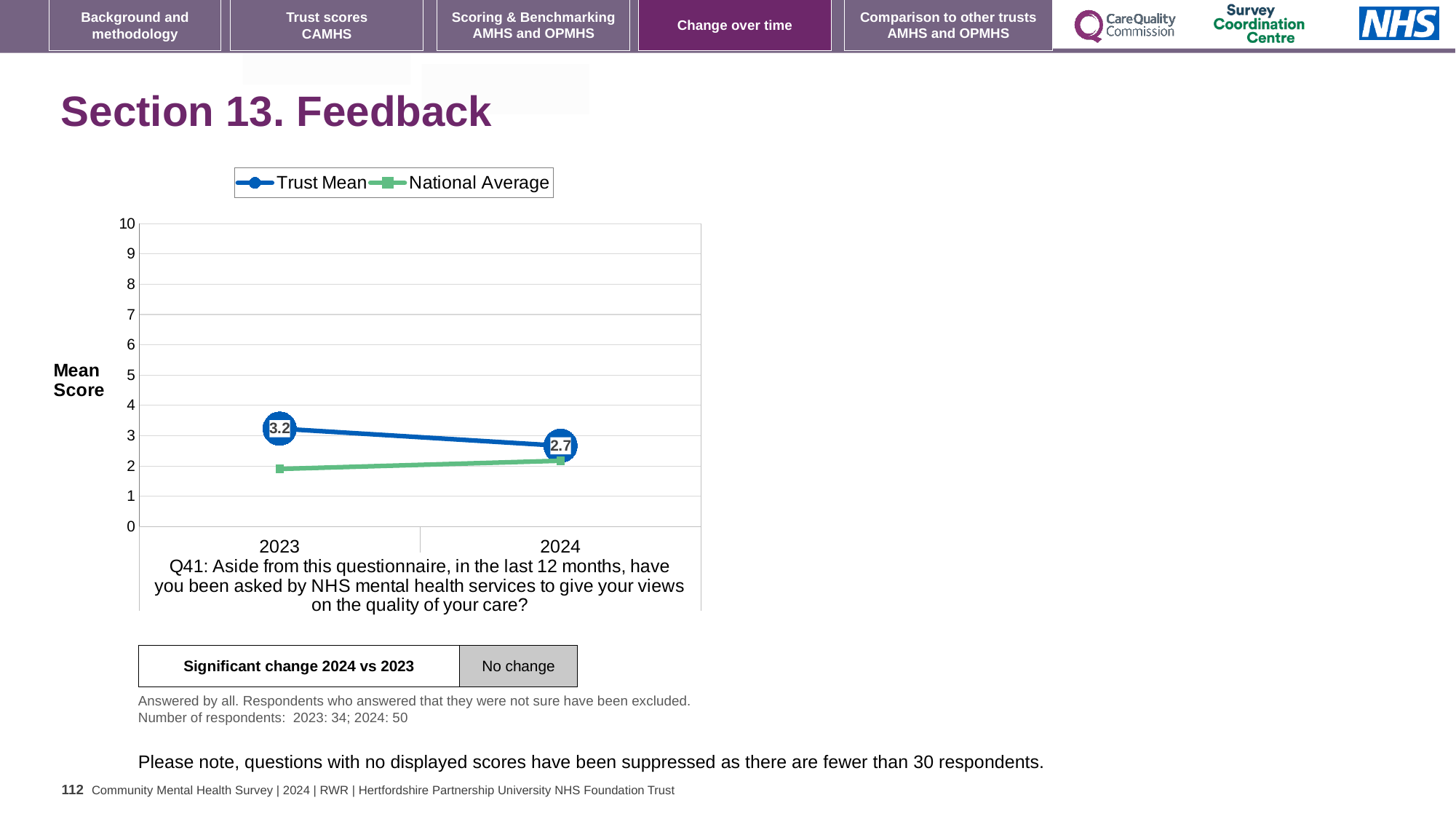
Does the Trust Mean line rise or fall from 2023 to 2024? fall How many years are shown on the x axis? 2 How many series does the legend list? 2 In which year was the Trust Mean score higher? 2023 Is the National Average value for 2023 greater or less than 3? less By how much did the Trust Mean score change from 2023 to 2024? 0.5 In which year was the Trust Mean score lower? 2024 What is the Trust Mean score for 2023? 3.2 In 2023, which is higher: the Trust Mean or the National Average? Trust Mean Does the National Average line rise or fall from 2023 to 2024? rise What kind of chart is shown on the slide? line chart What is the Trust Mean score for 2024? 2.7